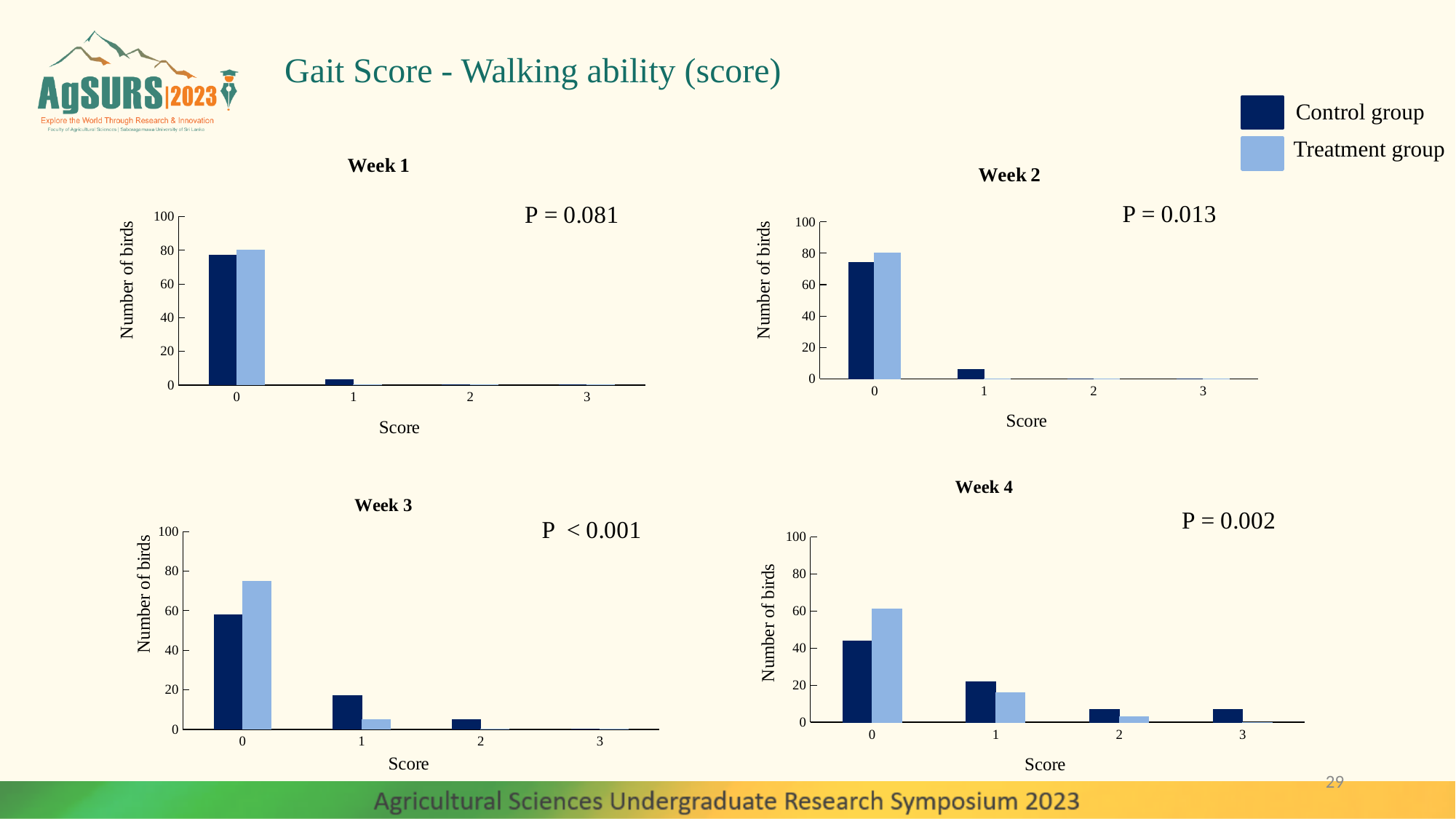
In the Week 3 chart, is the Treatment group value at score 0 greater or less than 60? greater In the Week 3 chart, which group has the larger value at score 0, Control group or Treatment group? Treatment group What P value is shown on the Week 2 chart? P = 0.013 In the Week 4 chart, which group has the larger value at score 0, Control group or Treatment group? Treatment group In the Week 4 chart, at which score is the Control group value highest? 0 In the Week 4 chart, is the Control group value at score 0 greater or less than 60? less In the Week 4 chart, do the Treatment group values rise or fall as the score increases from 0 to 3? fall How many series does the legend list? 2 What kind of chart is the Week 1 chart? bar chart In the Week 4 chart, how many score categories are shown on the x axis? 4 In the Week 3 chart, which group has the larger value at score 1, Control group or Treatment group? Control group In the Week 1 chart, is the Control group value at score 0 greater or less than 60? greater